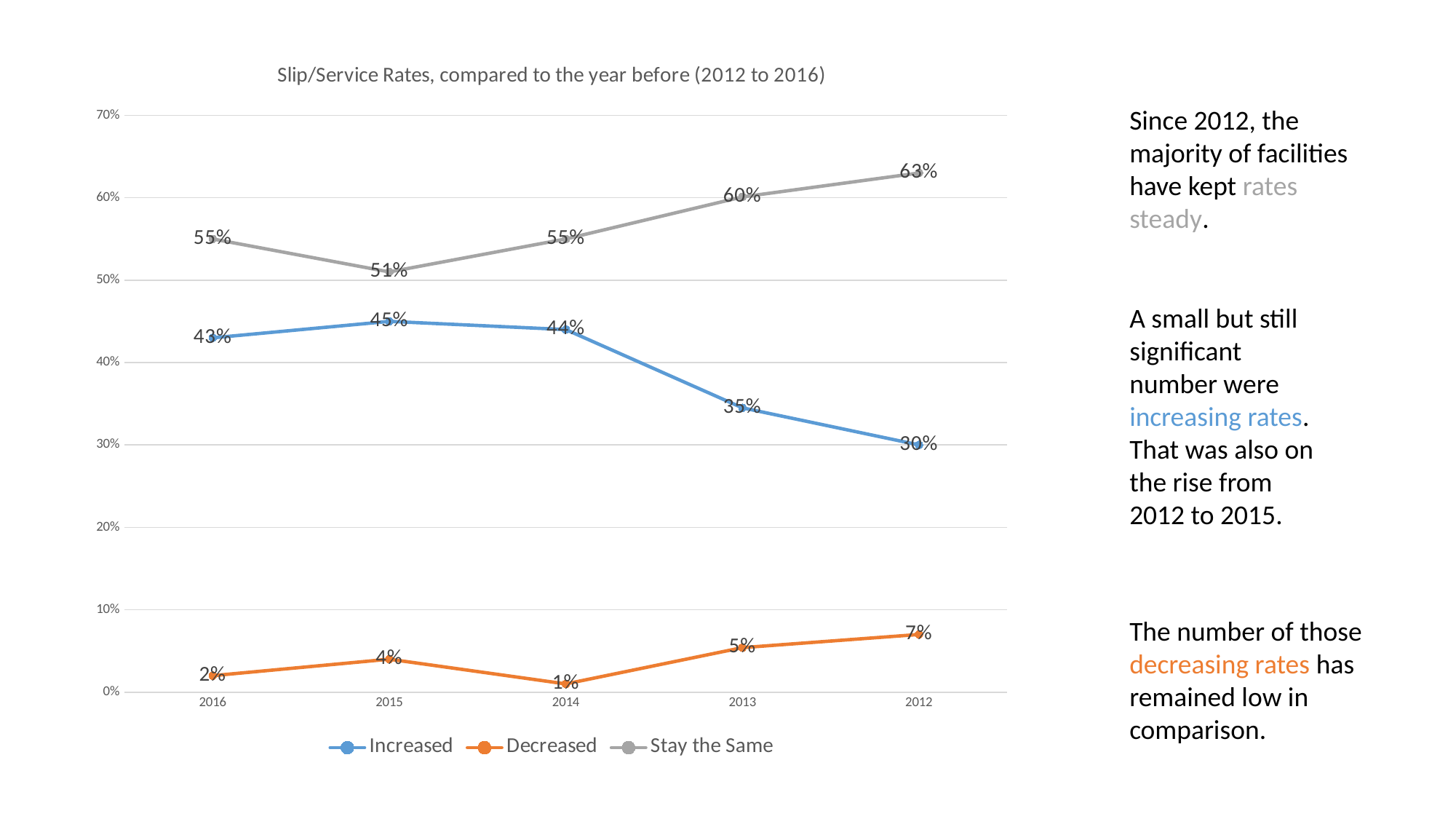
What is the title of the chart? Slip/Service Rates, compared to the year before (2012 to 2016) In which year is the Stay the Same series lowest? 2015 What is the difference between Stay the Same and Increased in 2016? 12% Which is larger in 2013, Increased or Stay the Same? Stay the Same What is the value for Increased in 2015? 45% How many series does the legend list? 3 How many years are shown on the x axis? 5 In which year is the Decreased series highest? 2012 Reading from 2014 to 2012 along the x axis, does the Increased series rise or fall? fall What is the value for Stay the Same in 2012? 63% What type of chart is shown on the slide? line chart What is the value for Decreased in 2014? 1%